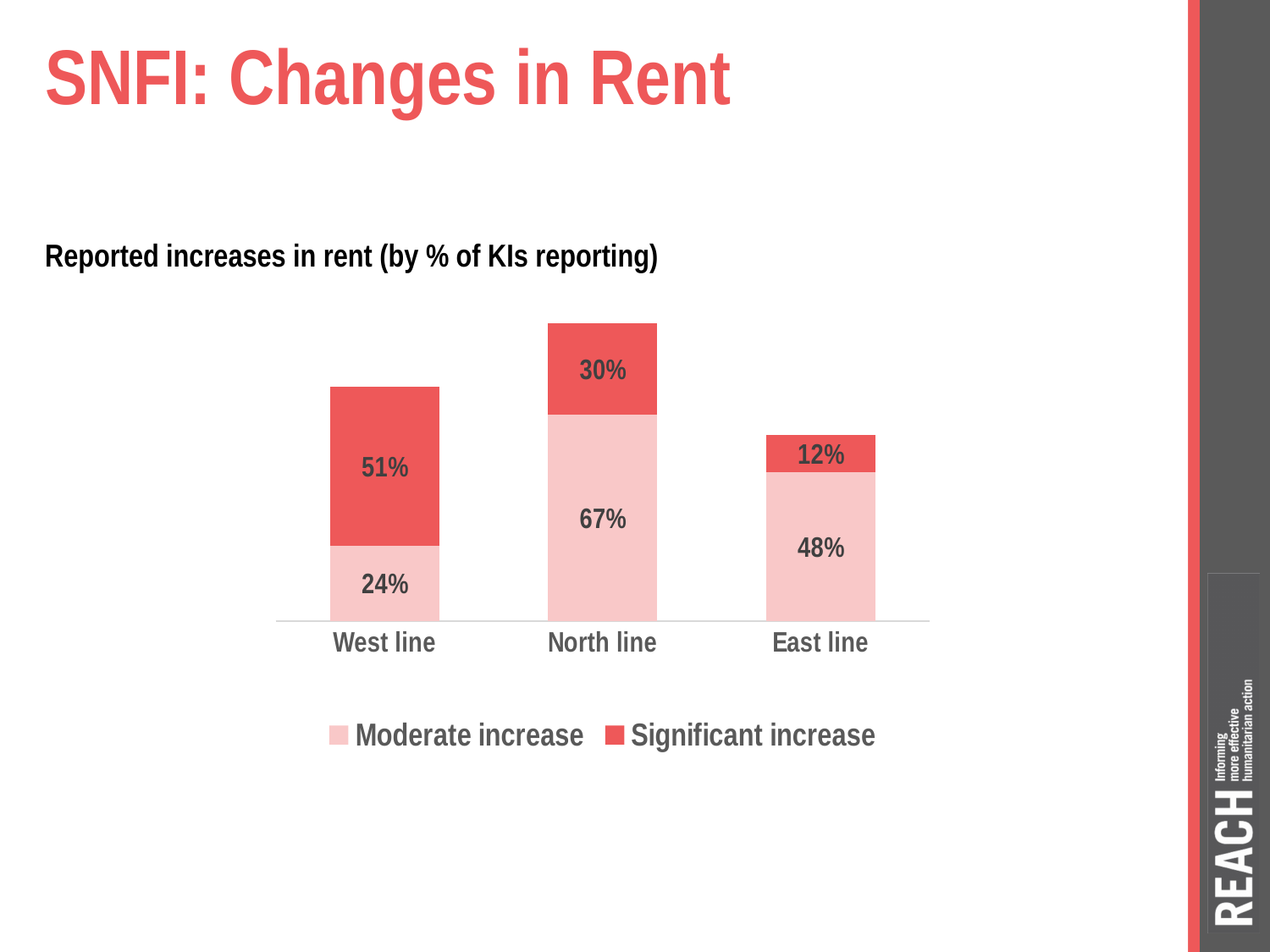
How many lines (categories) are shown on the chart? 3 What is the difference between the significant increase percentages for West line and East line? 39% Which is larger: the moderate increase percentage for North line or for East line? North line What percentage of KIs reported a moderate increase in rent for East line? 48% What kind of chart is shown on the slide? Stacked bar chart What percentage of KIs reported a moderate increase in rent for West line? 24% Which line has the lowest percentage of KIs reporting a moderate increase in rent? West line What is the total percentage of KIs reporting any increase in rent for West line? 75% How many series does the legend list? 2 What percentage of KIs reported a significant increase in rent for North line? 30% Which line has the highest percentage of KIs reporting a significant increase in rent? West line What is the total percentage of KIs reporting any increase in rent for North line? 97%